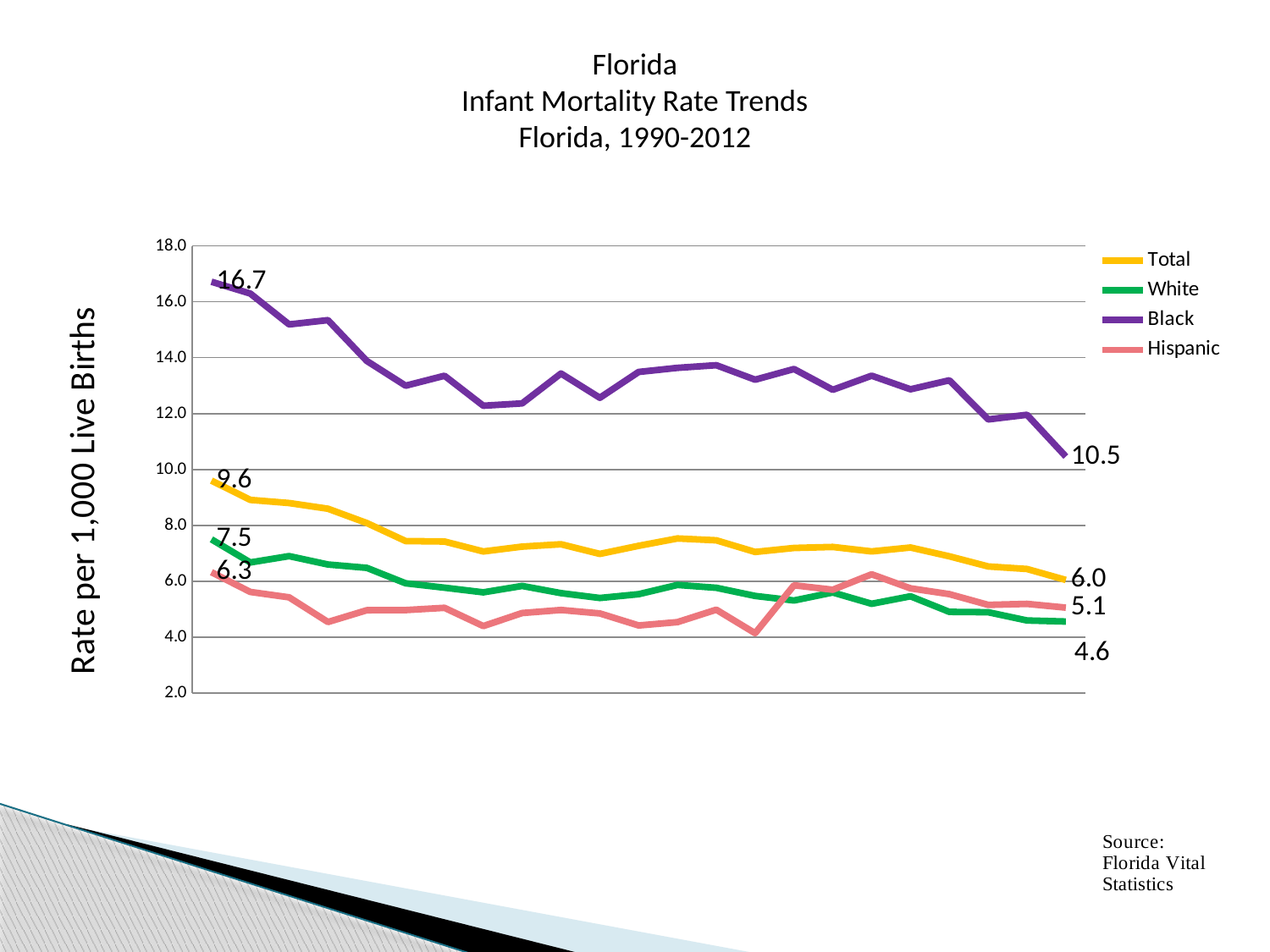
What is the infant mortality rate for White infants at the end of the series (2012)? 4.6 What is the Total infant mortality rate at the end of the series (2012)? 6.0 What is the infant mortality rate for Black infants at the end of the series (2012)? 10.5 By how much did the Black infant mortality rate fall from the start (16.7) to the end (10.5) of the series? 6.2 Which series has the highest infant mortality rate throughout the chart? Black What is the infant mortality rate for Hispanic infants at the start of the series (1990)? 6.3 What is the infant mortality rate for Black infants at the start of the series (1990)? 16.7 What is the Total infant mortality rate at the start of the series (1990)? 9.6 Does the Total infant mortality rate rise or fall over the period shown? fall What type of chart is shown on the slide? line chart What is the y-axis label of the chart? Rate per 1,000 Live Births How many series does the legend list? 4